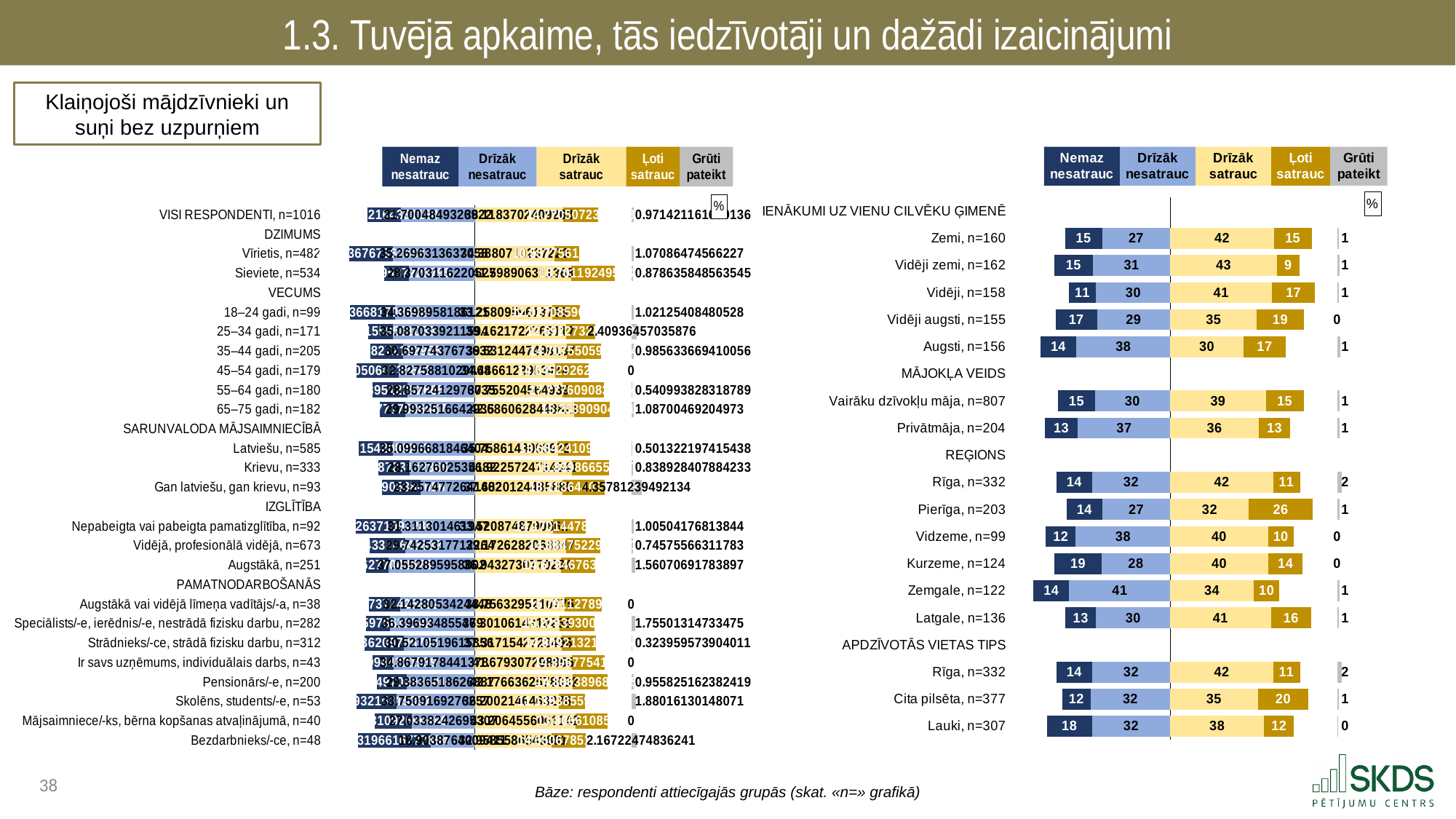
In the right chart, what is the difference between the "Drīzāk satrauc" values for Rīga, n=332 and Pierīga, n=203? 10 In the right chart, what is the value of "Ļoti satrauc" for Pierīga, n=203? 26 In the right chart, what is the value of "Drīzāk nesatrauc" for Augsti, n=156? 38 In the right chart, which is larger: the "Drīzāk nesatrauc" value for Zemgale, n=122 or for Latgale, n=136? Zemgale, n=122 How many series does the legend of the right chart list? 5 In the right chart, what is the value of "Nemaz nesatrauc" for Kurzeme, n=124? 19 In the right chart, which legend entry is shown in dark gold colour? Ļoti satrauc In the right chart, which region under REĢIONS has the highest "Ļoti satrauc" value? Pierīga, n=203 What kind of chart is the right chart? Stacked bar chart In the right chart, what is the total of the stacked bar for Zemi, n=160? 100 In the right chart, which income group under IENĀKUMI UZ VIENU CILVĒKU ĢIMENĒ has the lowest "Ļoti satrauc" value? Vidēji zemi, n=162 In the right chart, what is the value of "Drīzāk satrauc" for Zemi, n=160? 42